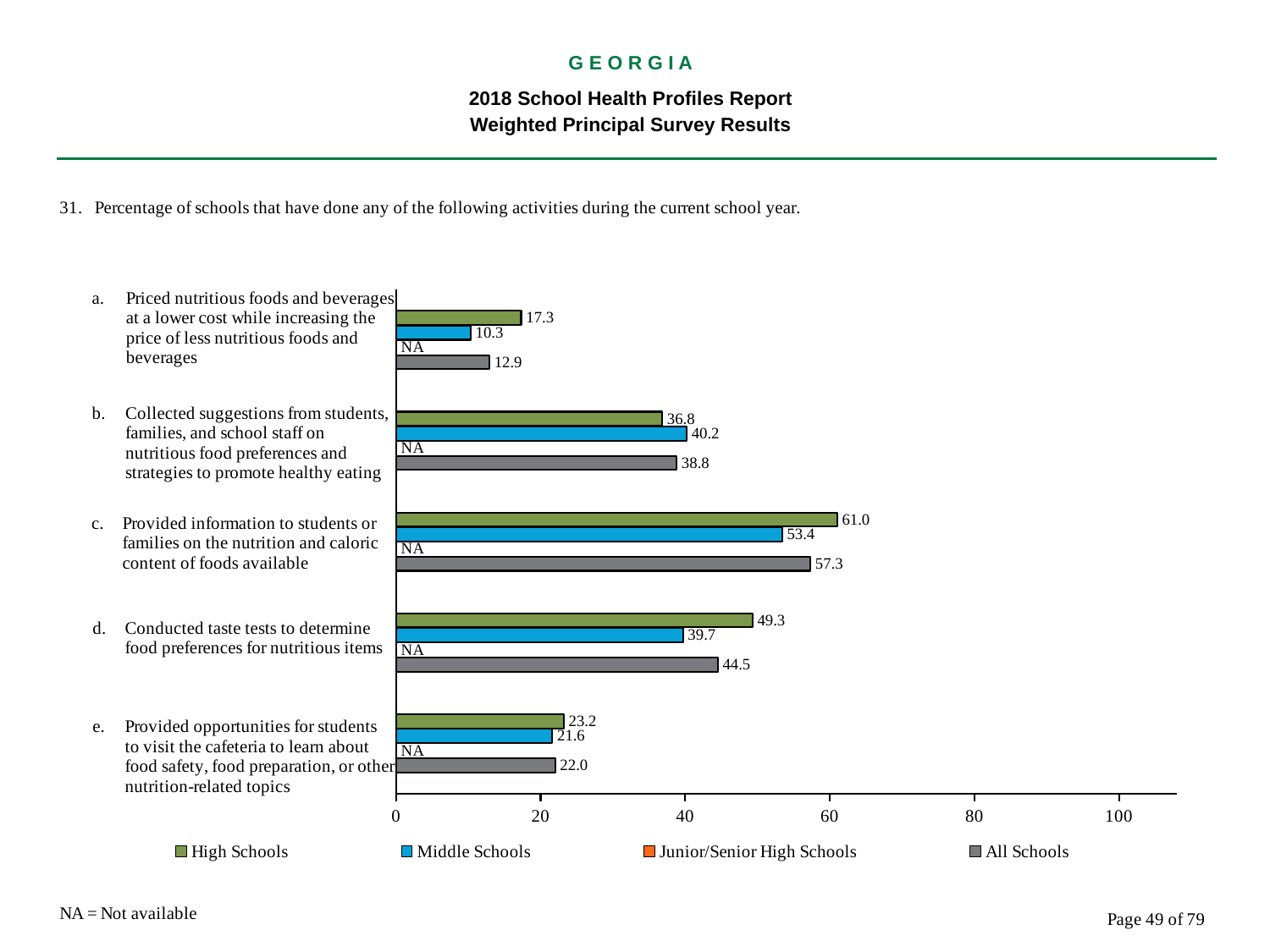
For activity b, collected suggestions from students, families, and school staff, which is larger: the High Schools value or the Middle Schools value? Middle Schools What is the difference between the High Schools and Middle Schools values for activity d, conducted taste tests? 9.6 Is the All Schools value for activity c, provided information on nutrition and caloric content, greater or less than 40? greater What value is shown for Junior/Senior High Schools for every activity? NA What is the value for High Schools for activity c, provided information to students or families on the nutrition and caloric content of foods available? 61.0 What is the value for All Schools for activity d, conducted taste tests to determine food preferences for nutritious items? 44.5 What is the value for Middle Schools for activity a, priced nutritious foods and beverages at a lower cost? 10.3 Which activity has the lowest value for High Schools? a. Priced nutritious foods and beverages at a lower cost while increasing the price of less nutritious foods and beverages How many activities (categories) are shown on the chart? 5 How many series does the legend list? 4 Which activity has the highest value for All Schools? c. Provided information to students or families on the nutrition and caloric content of foods available What kind of chart is shown on the slide? bar chart